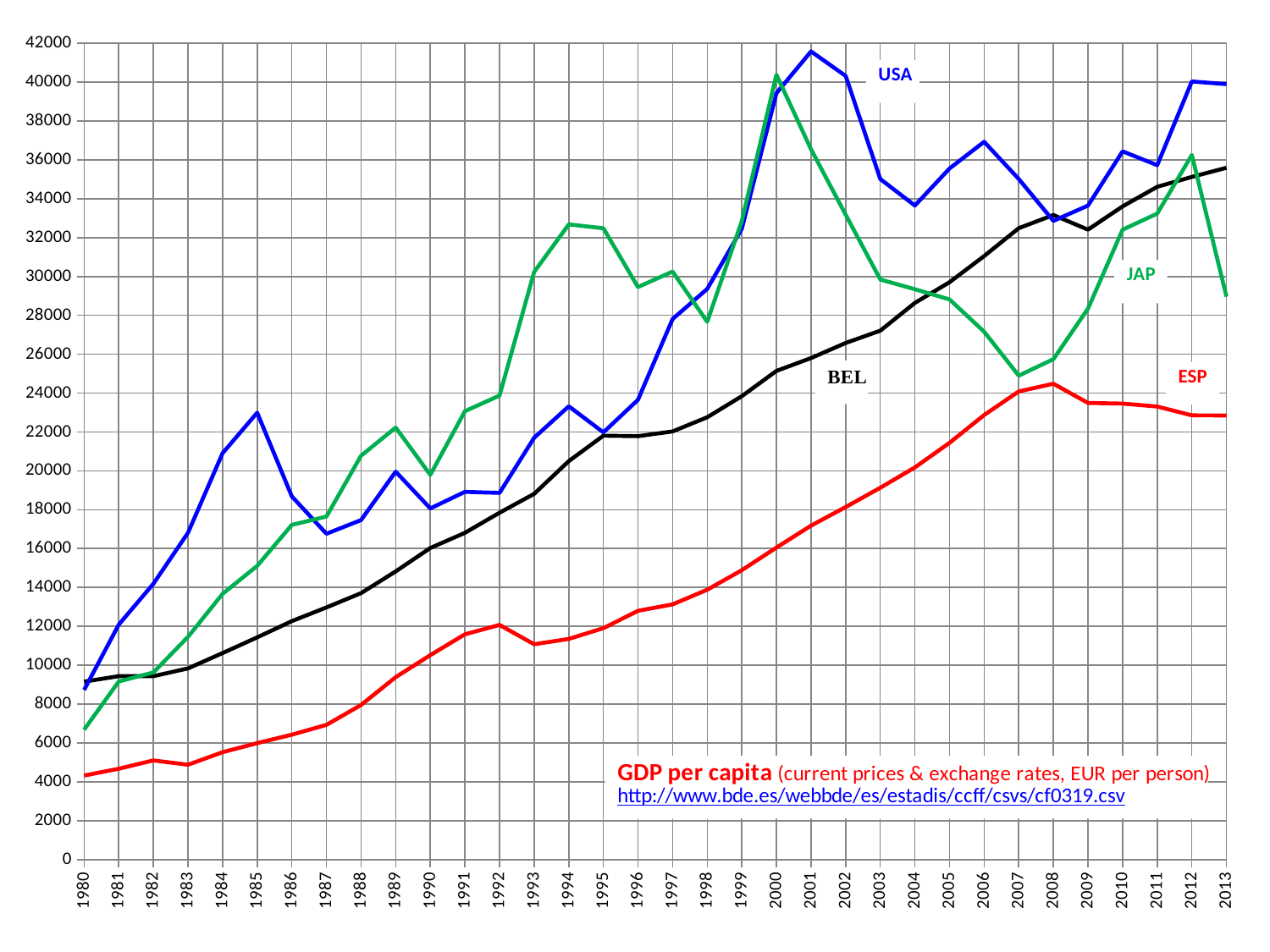
What kind of chart is shown on the slide? line chart Is the value for ESP in 2013 greater or less than 24000? less Which series has the highest value in 1994? JAP In 2007, which is larger, the value for BEL or the value for JAP? BEL Does the ESP line rise or fall from 1980 to 2008? rise Which series has the highest value in 2013? USA Is the value for JAP in 2013 greater or less than 30000? less Which series has the lowest value in 2013? ESP How many years are shown along the x axis? 34 Is the value for USA in 2001 greater or less than 40000? greater How many series are labelled on the chart? 4 What is the title of the chart? GDP per capita